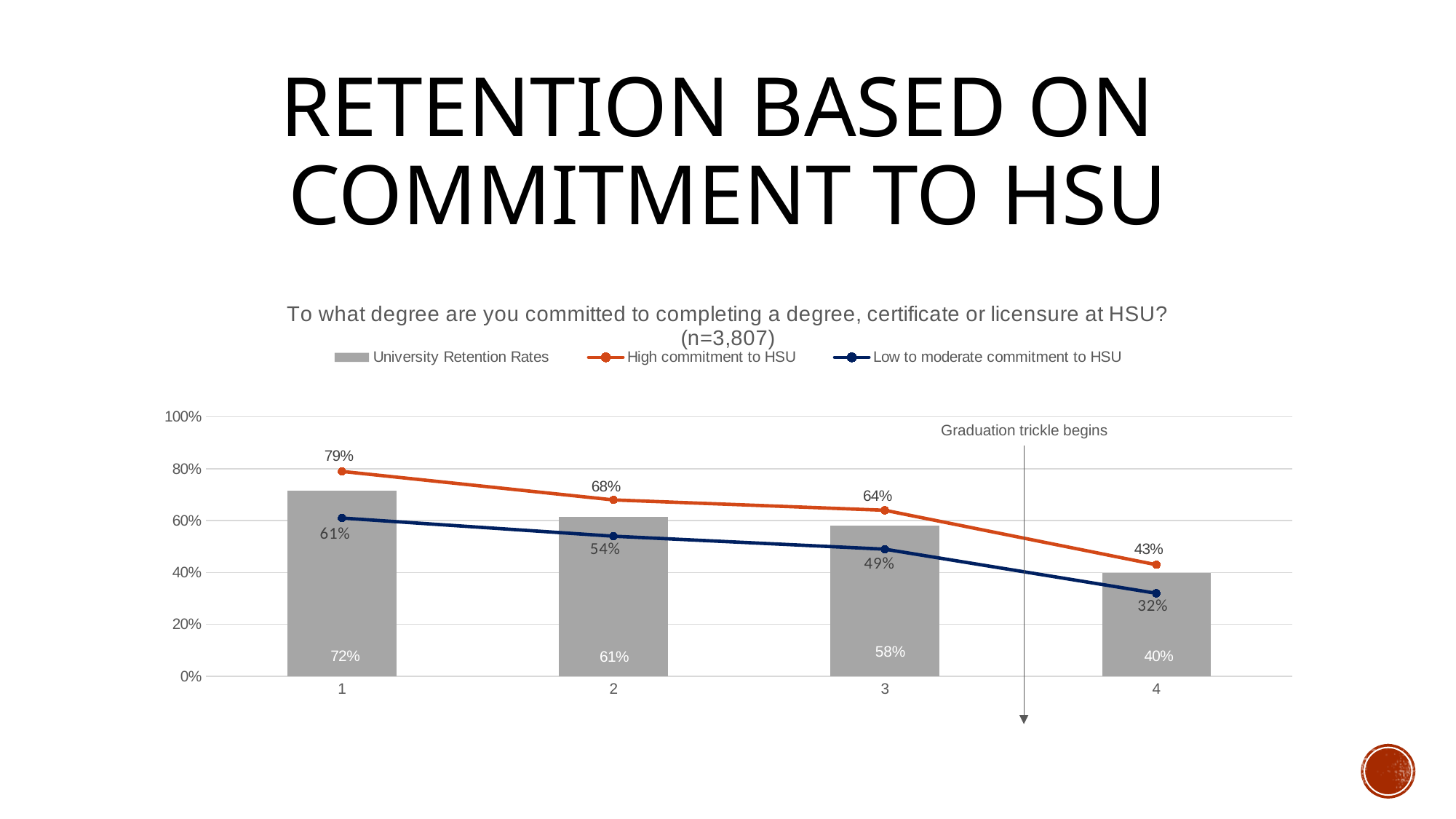
Which category has the lowest University Retention Rate? 4 How many series does the legend list? 3 What is the value for High commitment to HSU at category 3? 64% Do the High commitment to HSU values rise or fall from category 1 to category 4? Fall What is the sample size (n) shown in the chart title? 3,807 How many categories are shown on the x axis? 4 At category 3, which is larger: the University Retention Rate or the Low to moderate commitment to HSU value? University Retention Rates What is the University Retention Rate for category 1? 72% What kind of chart is this? Combined bar and line chart What is the value for Low to moderate commitment to HSU at category 4? 32% Which category has the highest value for High commitment to HSU? 1 What is the difference between High commitment to HSU and Low to moderate commitment to HSU at category 2? 14%